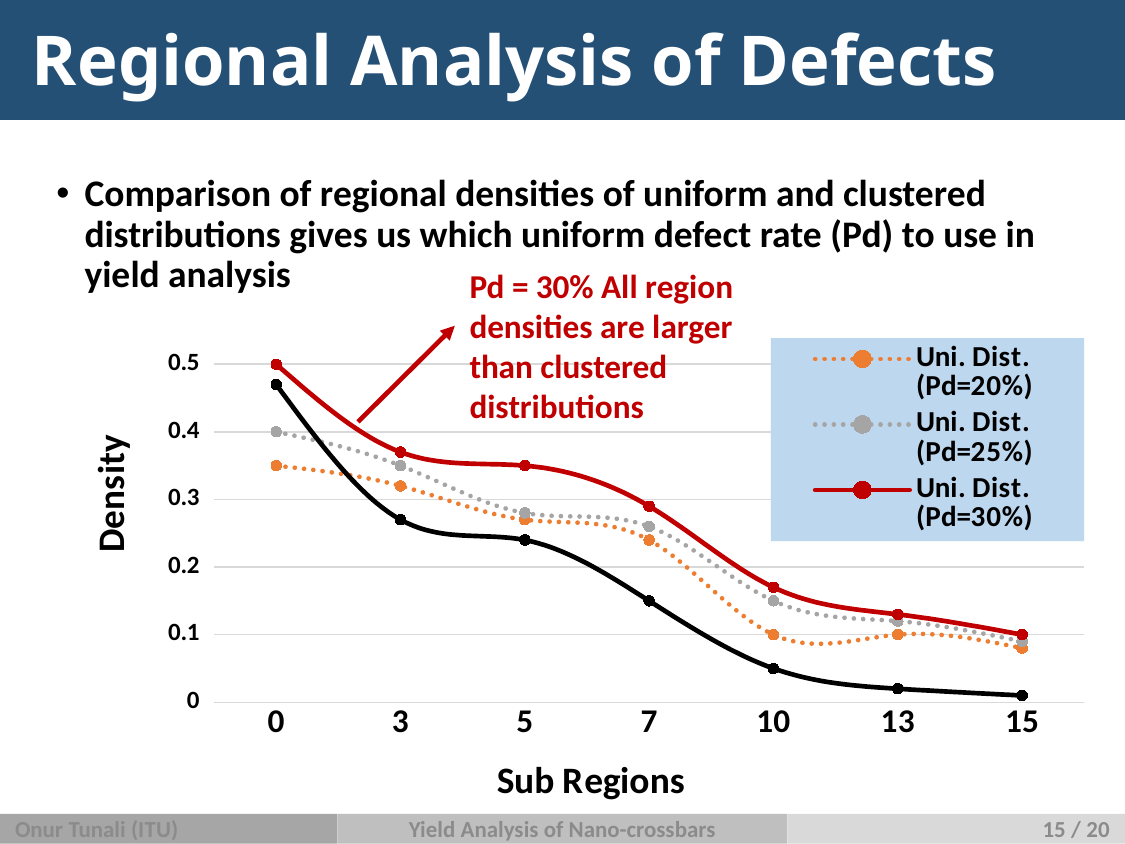
How many sub-region values are marked along the x axis? 7 How many series does the chart's legend list? 3 What is the label of the x axis of the chart? Sub Regions What kind of chart is shown on the slide? line chart Is the density of the Uni. Dist. (Pd=20%) series at sub region 7 greater or less than 0.3? less Is the density of the Uni. Dist. (Pd=30%) series at sub region 3 greater or less than 0.3? greater At sub region 3, which is larger: the density of the Uni. Dist. (Pd=30%) series or the black line? Uni. Dist. (Pd=30%) What is the density of the Uni. Dist. (Pd=25%) series at sub region 0? 0.4 What is the density of the Uni. Dist. (Pd=30%) series at sub region 0? 0.5 Do the densities rise or fall as the sub region number increases along the x axis? fall Is the density of the black line at sub region 10 greater or less than 0.1? less Which series has the highest density at sub region 0? Uni. Dist. (Pd=30%)